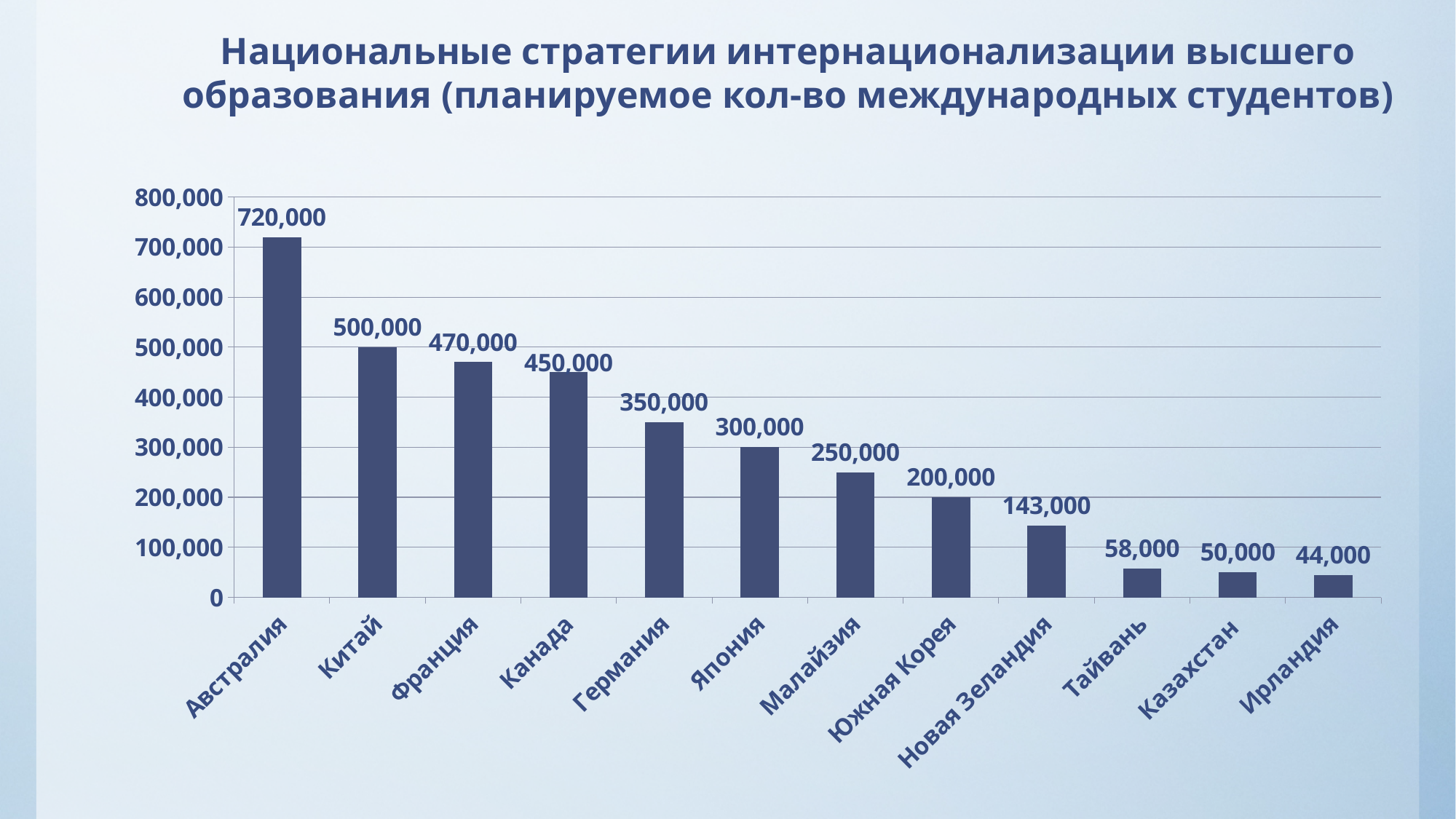
How many countries are shown on the chart? 12 What kind of chart is shown on the slide? bar chart Which is larger, the value for Германия or the value for Япония? Германия Do the values rise or fall from left to right along the x axis? fall What value is shown for Новая Зеландия? 143,000 Which country has the highest planned number of international students? Австралия Is the value for Малайзия greater or less than 300,000? less What is the planned number of international students for Австралия? 720,000 What is the difference between the values for Китай and Франция? 30,000 What value is shown for Тайвань? 58,000 Which country has the lowest value on the chart? Ирландия What is the difference between the values for Австралия and Канада? 270,000